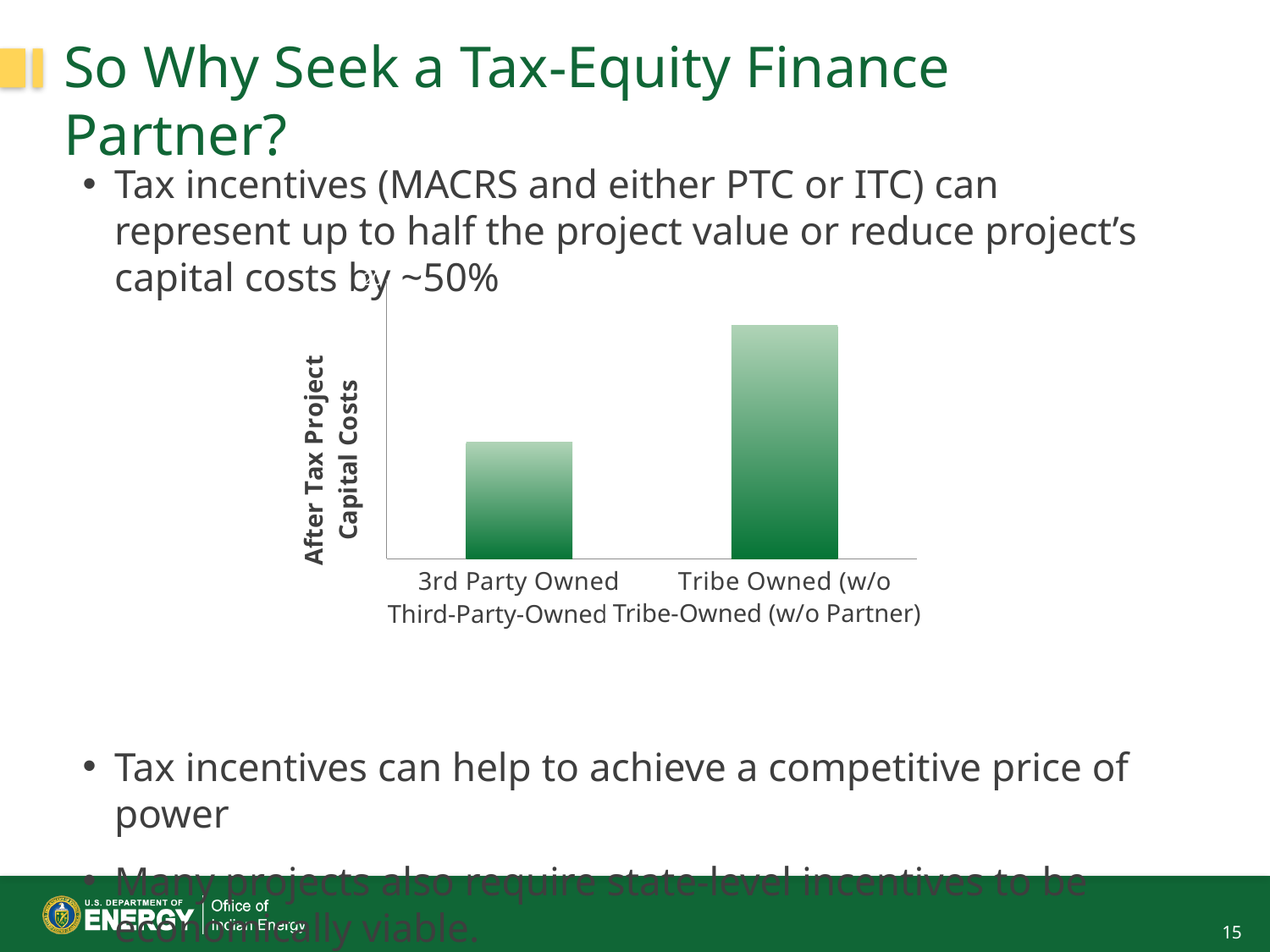
How many bars does the chart show? 2 Which category has the highest After Tax Project Capital Costs? Tribe Owned (w/o Partner) What kind of chart is shown on the slide? bar chart What colour are the bars in the chart? green Which is larger, the bar for 3rd Party Owned or the bar for Tribe Owned (w/o Partner)? Tribe Owned (w/o Partner) Do the bar values rise or fall from left to right across the chart? rise What is the title of the vertical axis of the chart? After Tax Project Capital Costs Which category has the lowest After Tax Project Capital Costs? 3rd Party Owned